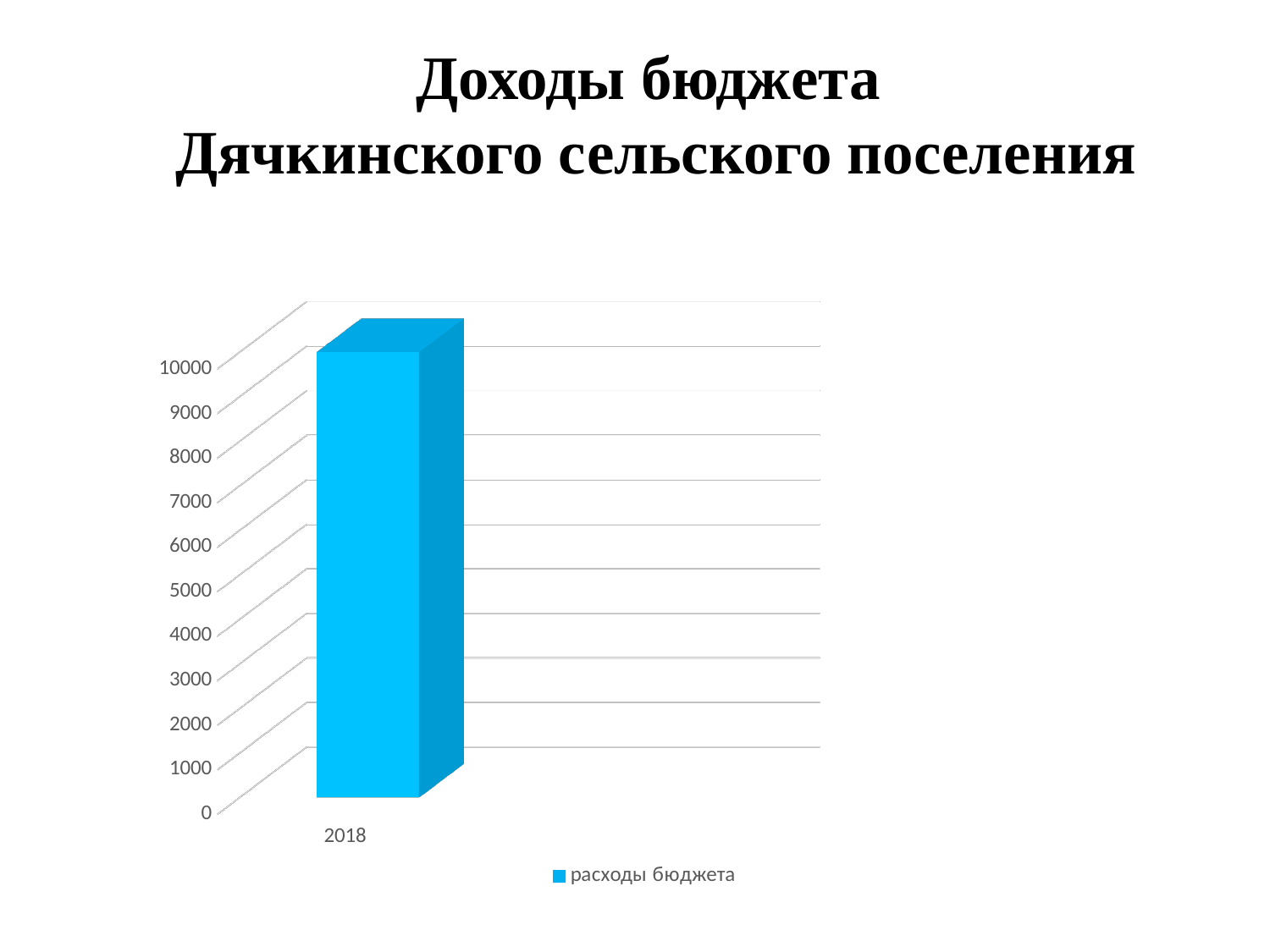
What kind of chart is shown on the slide? bar chart Is the value for 2018 greater or less than 9000? greater How many bars are plotted in the chart? 1 Is the value for 2018 greater or less than 8000? greater Which year is shown on the x axis of the chart? 2018 Is the value for 2018 greater or less than 5000? greater What series name does the legend show? расходы бюджета How many series does the legend list? 1